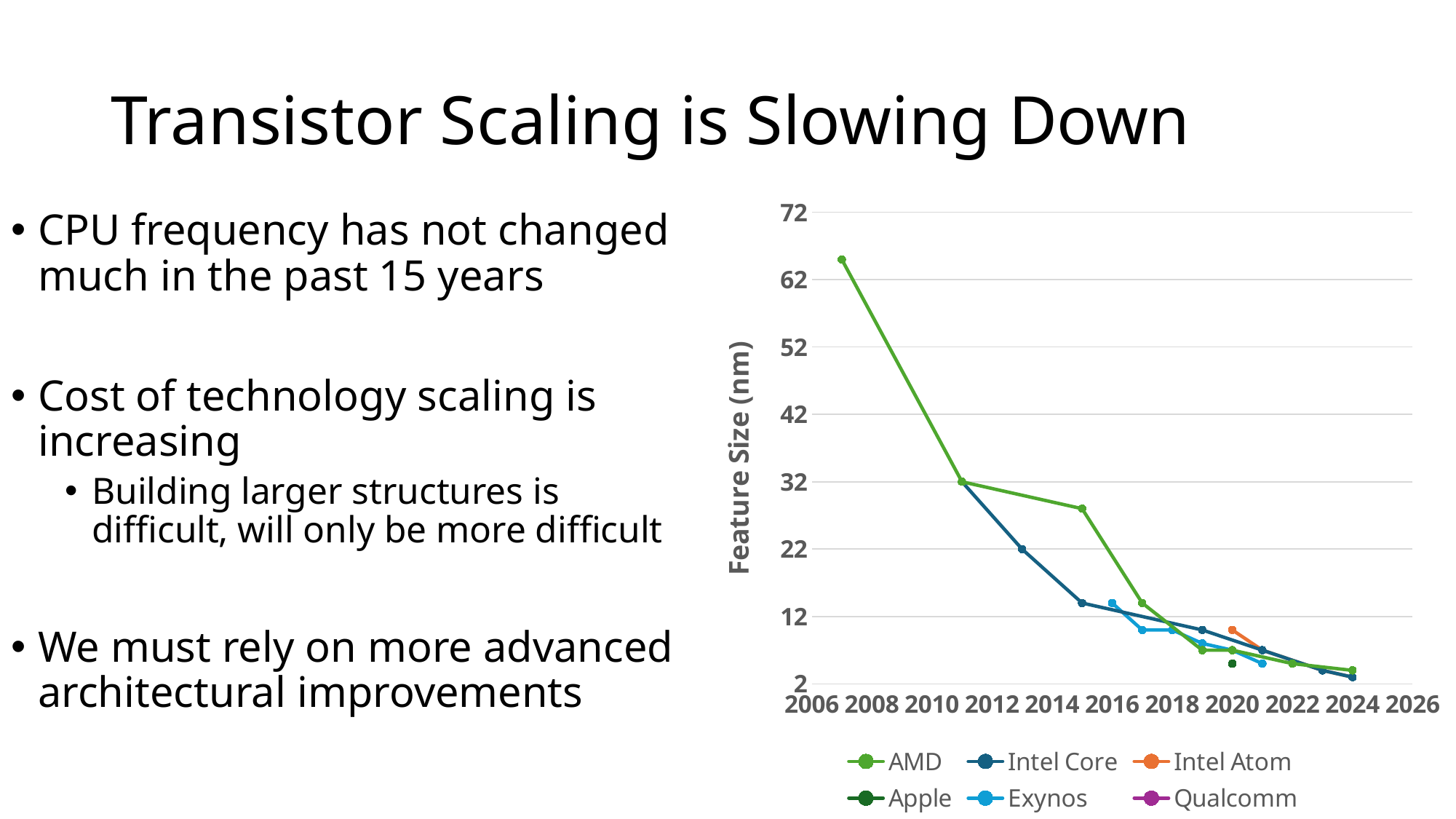
What is the AMD feature size in 2011? 32 Is the AMD value in 2007 greater or less than 52? greater What kind of chart is shown on the slide? line chart Which series reaches the highest feature size on the chart? AMD In 2015, which series has the larger feature size, AMD or Intel Core? AMD What is the Intel Core feature size in 2013? 22 What is the label on the vertical axis of the chart? Feature Size (nm) Is the Intel Core value in 2013 greater or less than 32? less Does the AMD feature size rise or fall from 2007 to 2024? fall Which series is drawn in orange in the chart? Intel Atom How many series does the chart legend list? 6 Is the AMD value in 2015 greater or less than 22? greater